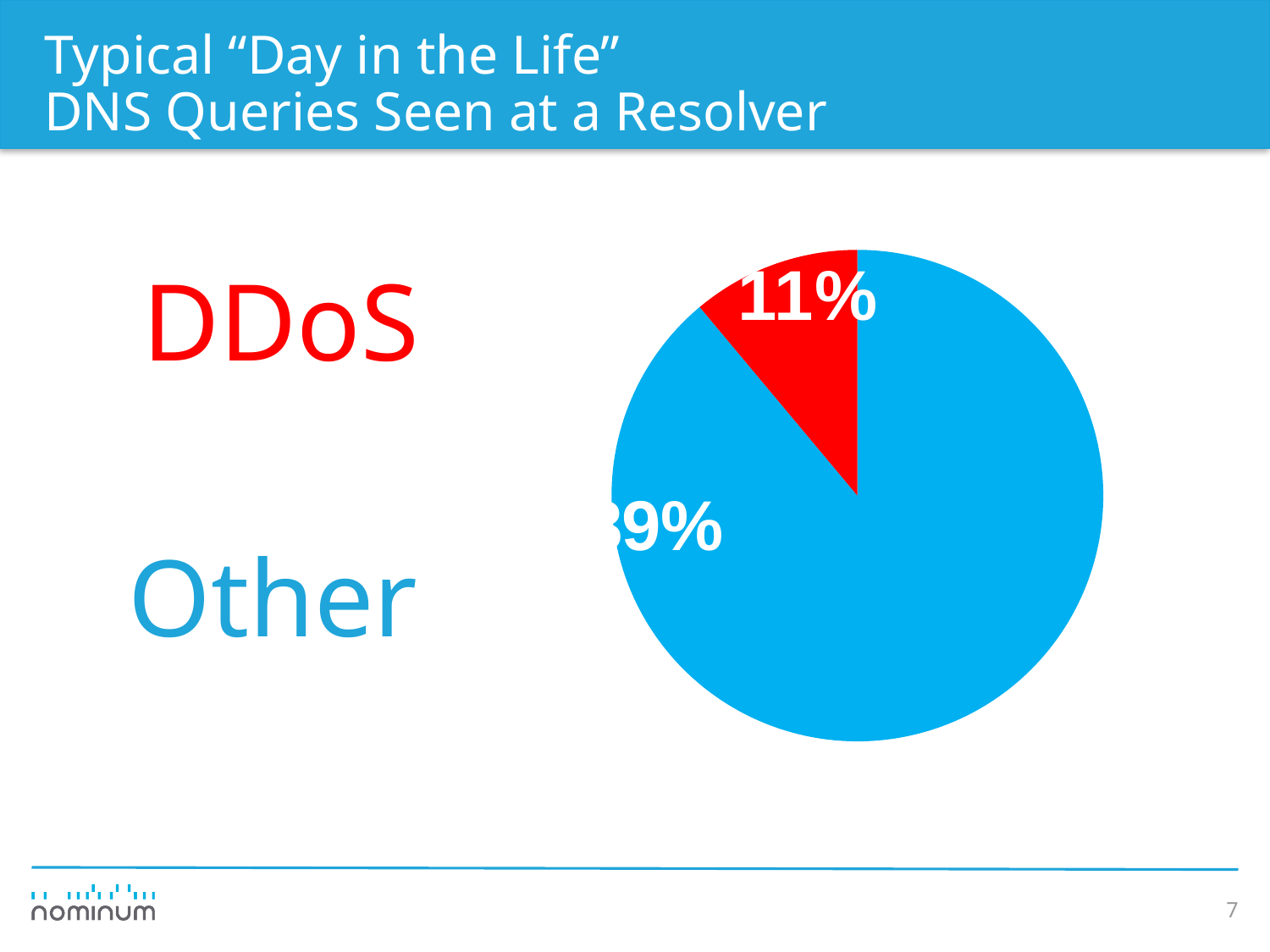
What is the title of the slide containing the pie chart? Typical "Day in the Life" DNS Queries Seen at a Resolver How many slices does the pie chart have? 2 Is the share for Other greater or less than 50%? greater Is the share for DDoS greater or less than 25%? less What kind of chart is shown on the slide? pie chart Which category has the smallest slice of the pie? DDoS What share of the pie does the Other slice represent? 89% Which is larger, the DDoS slice or the Other slice? Other What colour is the DDoS slice of the pie? red Which category has the largest slice of the pie? Other What percentage of DNS queries does the DDoS slice represent? 11%